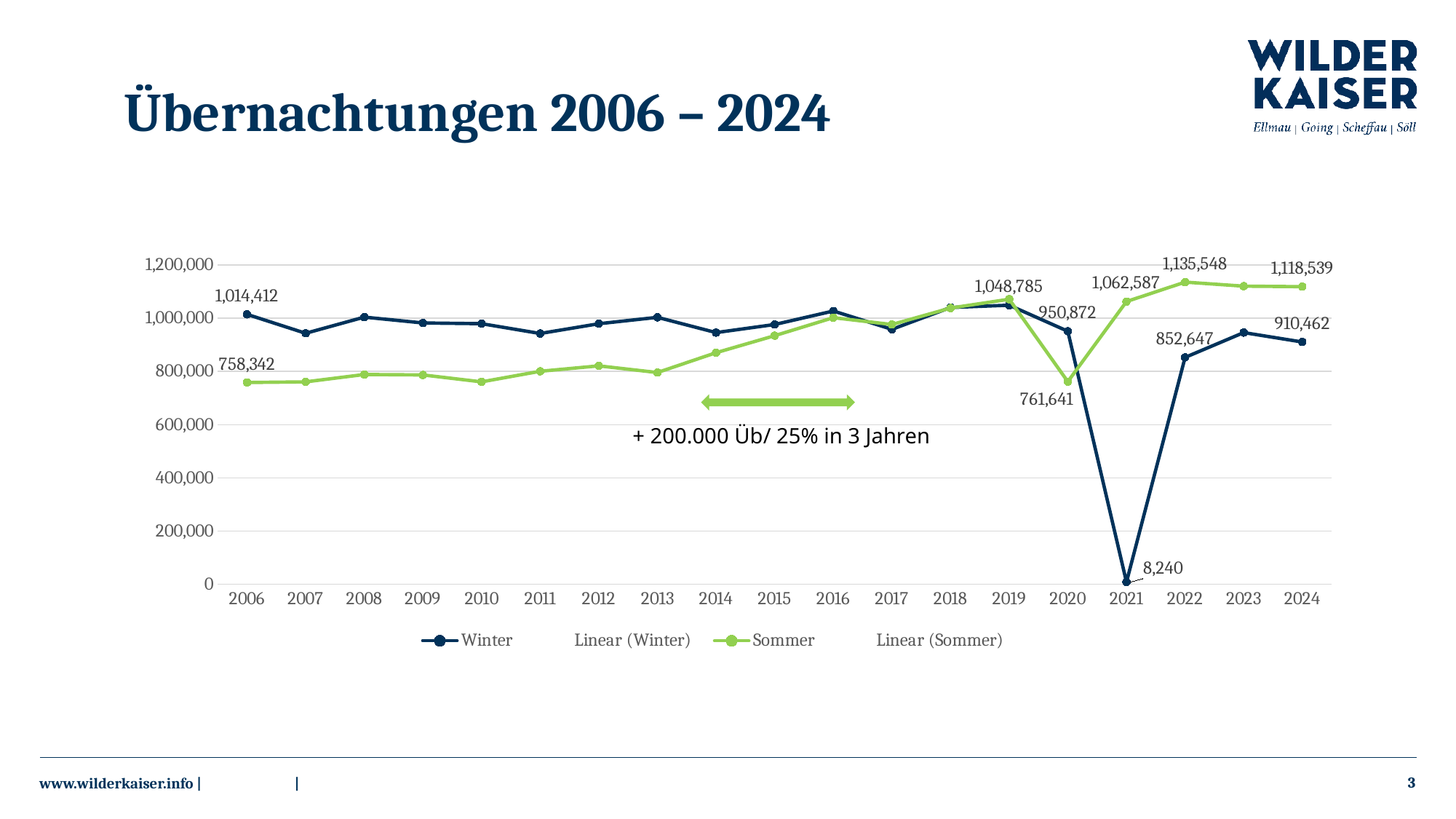
Is the Sommer value for 2010 greater or less than 800,000? less In 2020, which is larger, the Winter value or the Sommer value? Winter How many years are shown on the x axis of the chart? 19 In which year is the Winter value lowest? 2021 In which year is the Sommer value highest? 2022 How many entries does the chart legend list? 4 What kind of chart is shown on the slide? line chart What is the Winter value for 2006? 1,014,412 What is the Sommer value for 2022? 1,135,548 What is the Winter value for 2021? 8,240 What is the difference between the Sommer and Winter values in 2024? 208,077 What is the Sommer value for 2006? 758,342